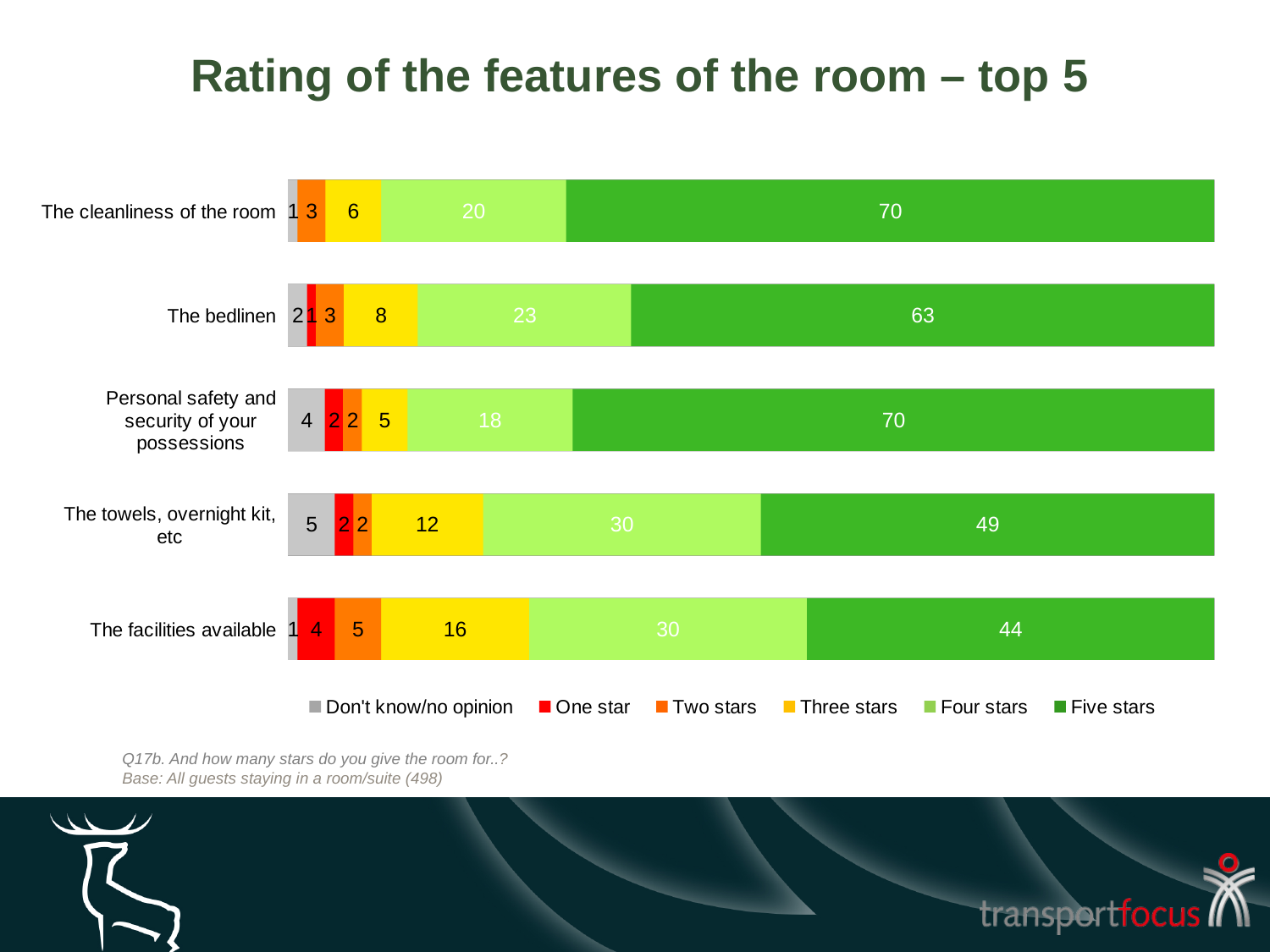
What is the total of the stacked bar for 'The towels, overnight kit, etc'? 100 Which has a larger Five stars value: 'The bedlinen' or 'The towels, overnight kit, etc'? The bedlinen What is the Five stars value for 'The bedlinen'? 63 What is the Four stars value for 'The towels, overnight kit, etc'? 30 What kind of chart is shown on the slide? Stacked bar chart How many series does the legend list? 6 What percentage of guests gave five stars for the cleanliness of the room? 70 What is the difference between the Five stars values for 'The cleanliness of the room' and 'The facilities available'? 26 Which feature has the lowest Five stars value? The facilities available How many room features are shown in the chart? 5 Which feature has the highest Three stars value? The facilities available What is the Three stars value for 'The facilities available'? 16